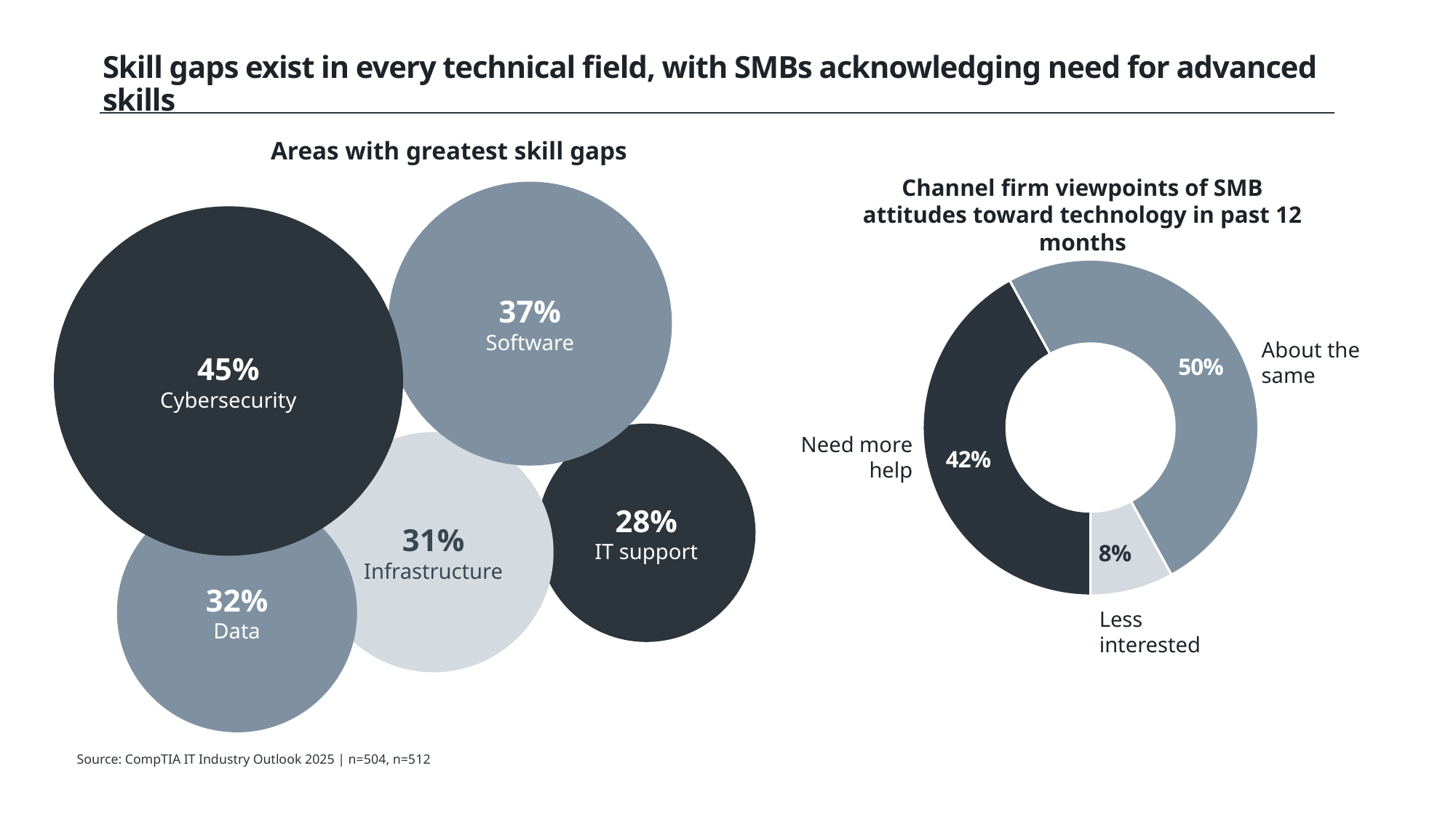
In the 'Areas with greatest skill gaps' chart, what is the value for Infrastructure? 31% In the 'Areas with greatest skill gaps' chart, which area has the lowest value? IT support How many areas are shown in the 'Areas with greatest skill gaps' chart? 5 In the 'Areas with greatest skill gaps' chart, which is larger, Data or Infrastructure? Data In the 'Channel firm viewpoints of SMB attitudes toward technology in past 12 months' chart, what is the difference between 'About the same' and 'Need more help'? 8 percentage points In the 'Channel firm viewpoints of SMB attitudes toward technology in past 12 months' chart, what share is 'Need more help'? 42% In the 'Areas with greatest skill gaps' chart, what is the difference between Cybersecurity and Software? 8 percentage points In the 'Channel firm viewpoints of SMB attitudes toward technology in past 12 months' chart, which category has the smallest share? Less interested In the 'Areas with greatest skill gaps' chart, what is the value for Cybersecurity? 45% What kind of chart is the 'Areas with greatest skill gaps' chart? Bubble chart In the 'Areas with greatest skill gaps' chart, which area has the highest value? Cybersecurity What kind of chart is the 'Channel firm viewpoints of SMB attitudes toward technology in past 12 months' chart? Doughnut chart